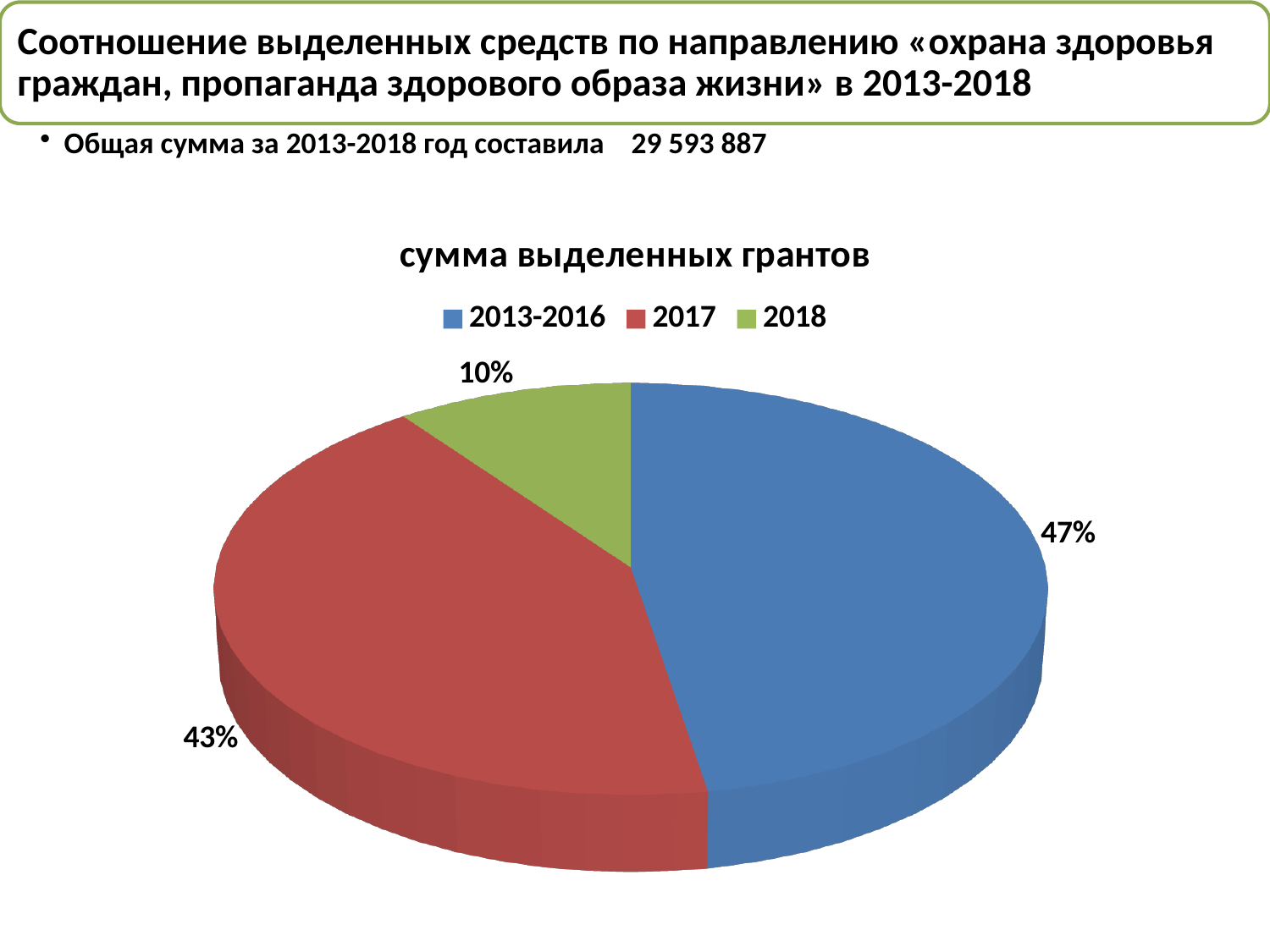
What share of the pie does the 2018 slice represent? 10% How many slices does the pie chart have? 3 What colour is the 2018 slice? green Which category has the largest share of the pie? 2013-2016 Which category has the smallest share of the pie? 2018 What share of the pie does the 2017 slice represent? 43% What is the chart's title? сумма выделенных грантов What is the difference in percentage points between the 2013-2016 share and the 2017 share? 4 What kind of chart is shown on the slide? pie chart Which is larger, the share for 2017 or the share for 2018? 2017 What share of the pie does the 2013-2016 slice represent? 47% How many entries does the legend list? 3